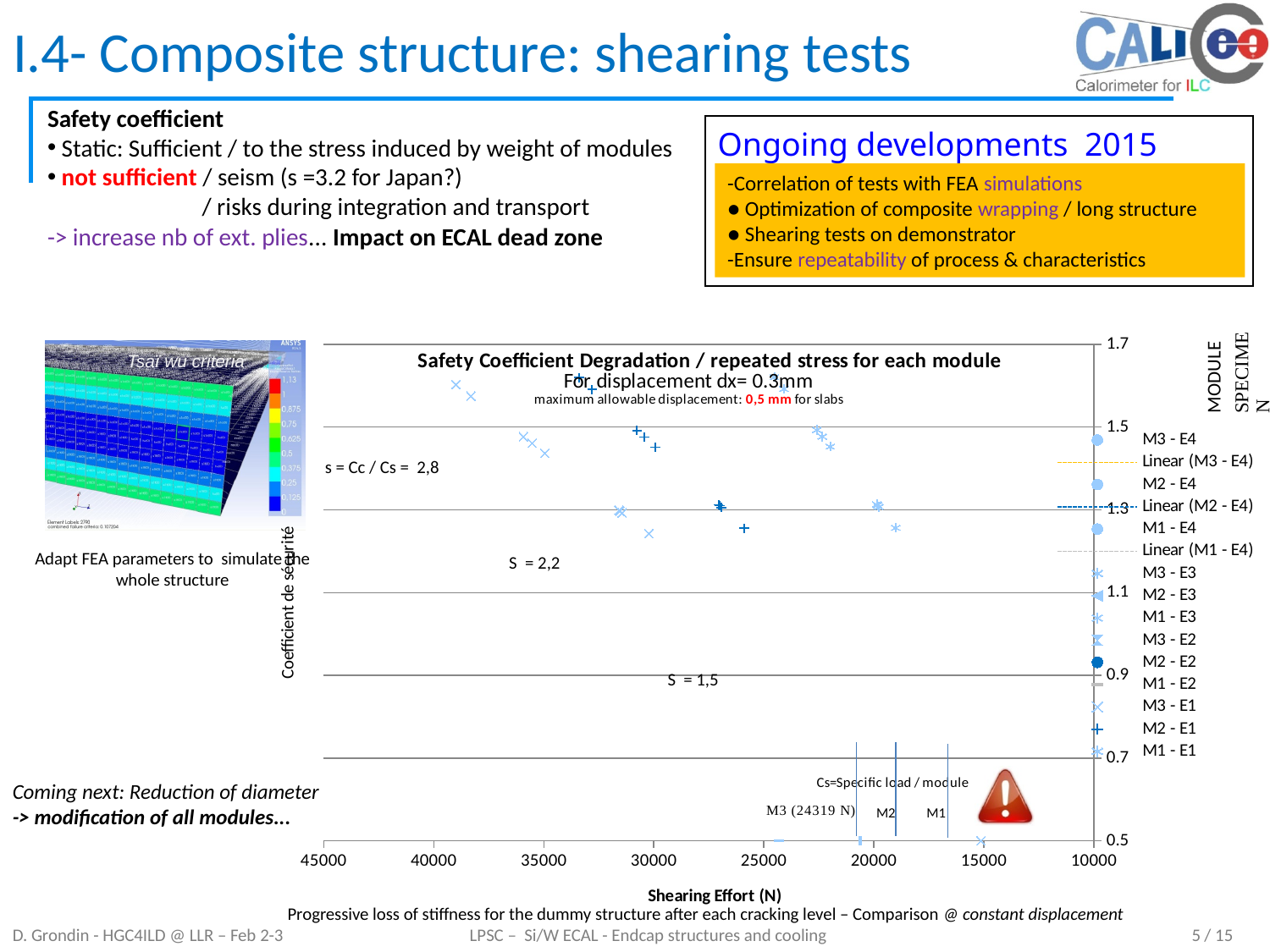
What kind of chart is shown on the slide? scatter chart What is the lowest value shown on the chart's y axis? 0.5 What maximum allowable displacement for slabs is stated on the chart? 0,5 mm What is the title of the chart? Safety Coefficient Degradation / repeated stress for each module What displacement dx is stated in the chart's subtitle? 0.3mm What shearing effort value is printed next to the M3 label on the chart? 24319 N What is the label of the chart's x axis? Shearing Effort (N) What value of s = Cc / Cs is annotated on the chart? 2,8 How many entries does the chart's legend list? 15 What is the lowest S value annotated on the chart? 1,5 What is the highest value shown on the chart's y axis? 1.7